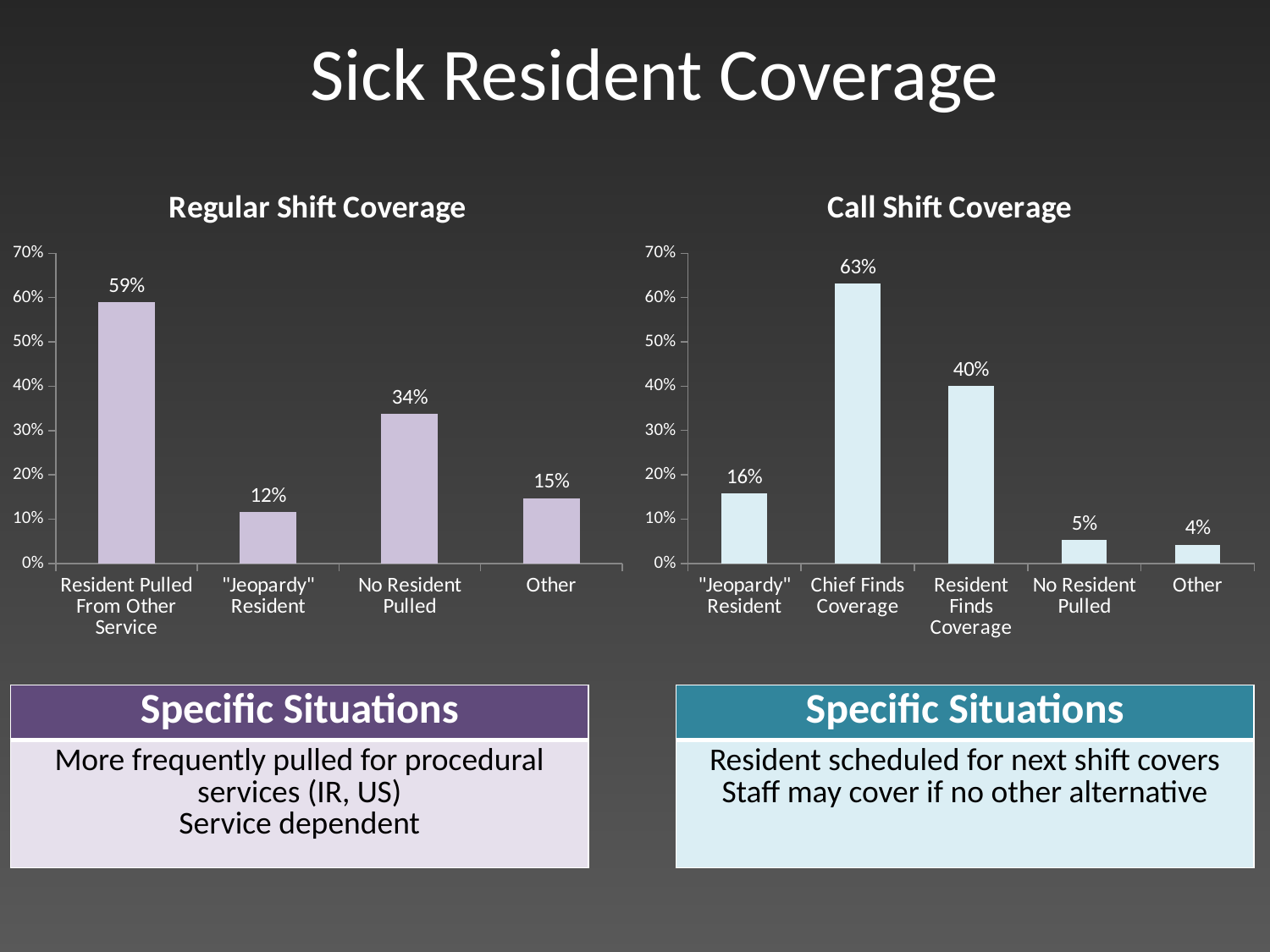
In the Call Shift Coverage chart, what is the value for Chief Finds Coverage? 63% What kind of chart is the Regular Shift Coverage chart? Bar chart In the Regular Shift Coverage chart, what is the value for No Resident Pulled? 34% In the Call Shift Coverage chart, what is the difference between "Jeopardy" Resident and No Resident Pulled? 11% In the Regular Shift Coverage chart, which category has the lowest value? "Jeopardy" Resident In the Regular Shift Coverage chart, which is larger: Other or "Jeopardy" Resident? Other How many categories are shown in the Regular Shift Coverage chart? 4 In the Call Shift Coverage chart, which category has the highest value? Chief Finds Coverage How many categories are shown in the Call Shift Coverage chart? 5 In the Call Shift Coverage chart, what is the difference between Chief Finds Coverage and Resident Finds Coverage? 23% In the Regular Shift Coverage chart, what is the value for Resident Pulled From Other Service? 59% In the Call Shift Coverage chart, what is the value for Resident Finds Coverage? 40%